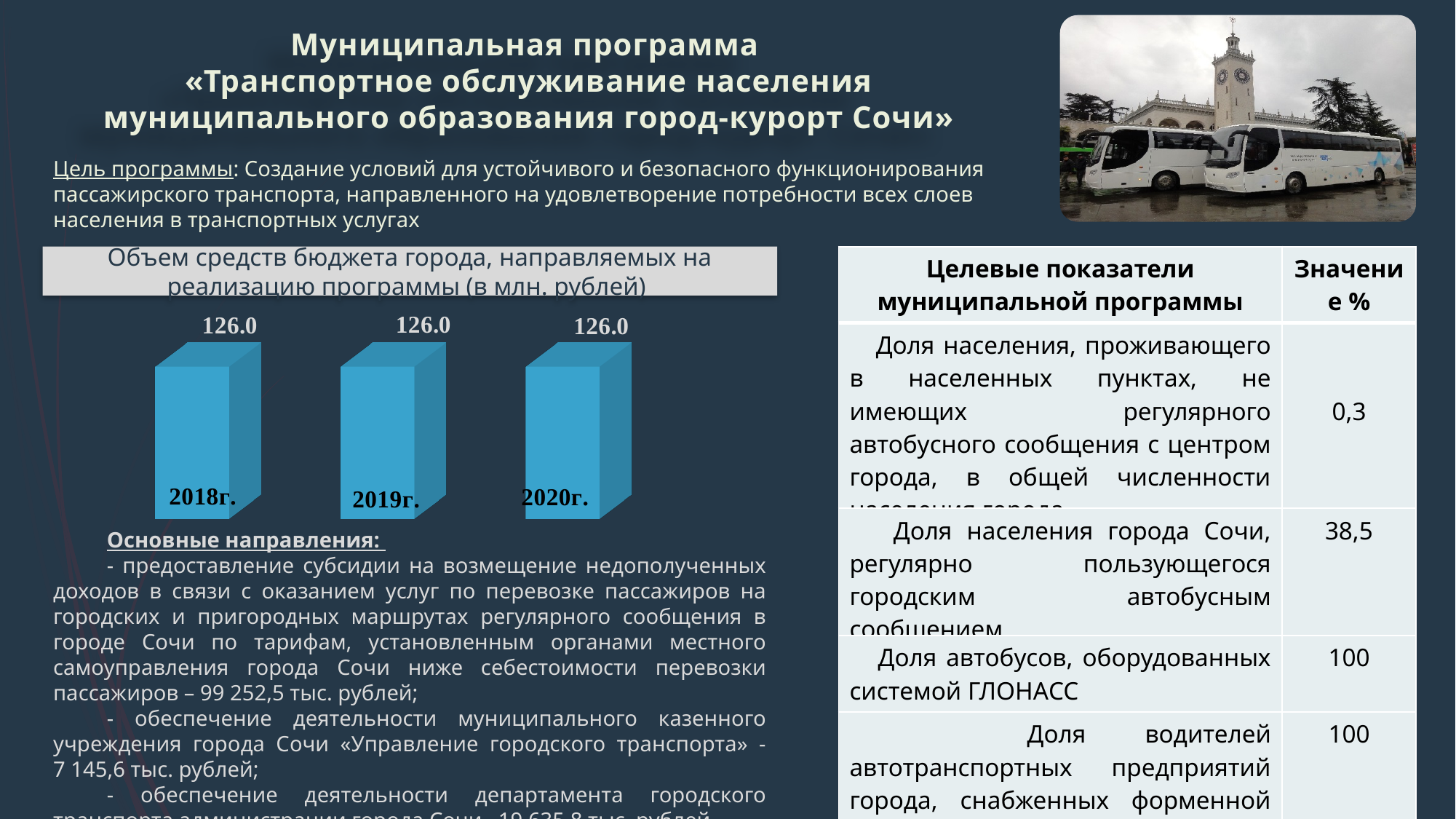
What is the title of the bar chart on the slide? Объем средств бюджета города, направляемых на реализацию программы (в млн. рублей) What is the difference between the values for 2020г. and 2018г. in the budget chart? 0.0 What is the value for 2019г. in the budget chart? 126.0 In what units are the values of the budget chart expressed, according to its title? млн. рублей Do the values in the budget chart rise, fall or stay the same from 2018г. to 2020г.? stay the same What is the value for 2018г. in the chart "Объем средств бюджета города, направляемых на реализацию программы (в млн. рублей)"? 126.0 What kind of chart is used to show the budget funds for the programme? bar chart What is the value for 2020г. in the budget chart? 126.0 How many bars (years) are shown in the budget chart? 3 Is the value for 2019г. in the budget chart greater or less than 100? greater